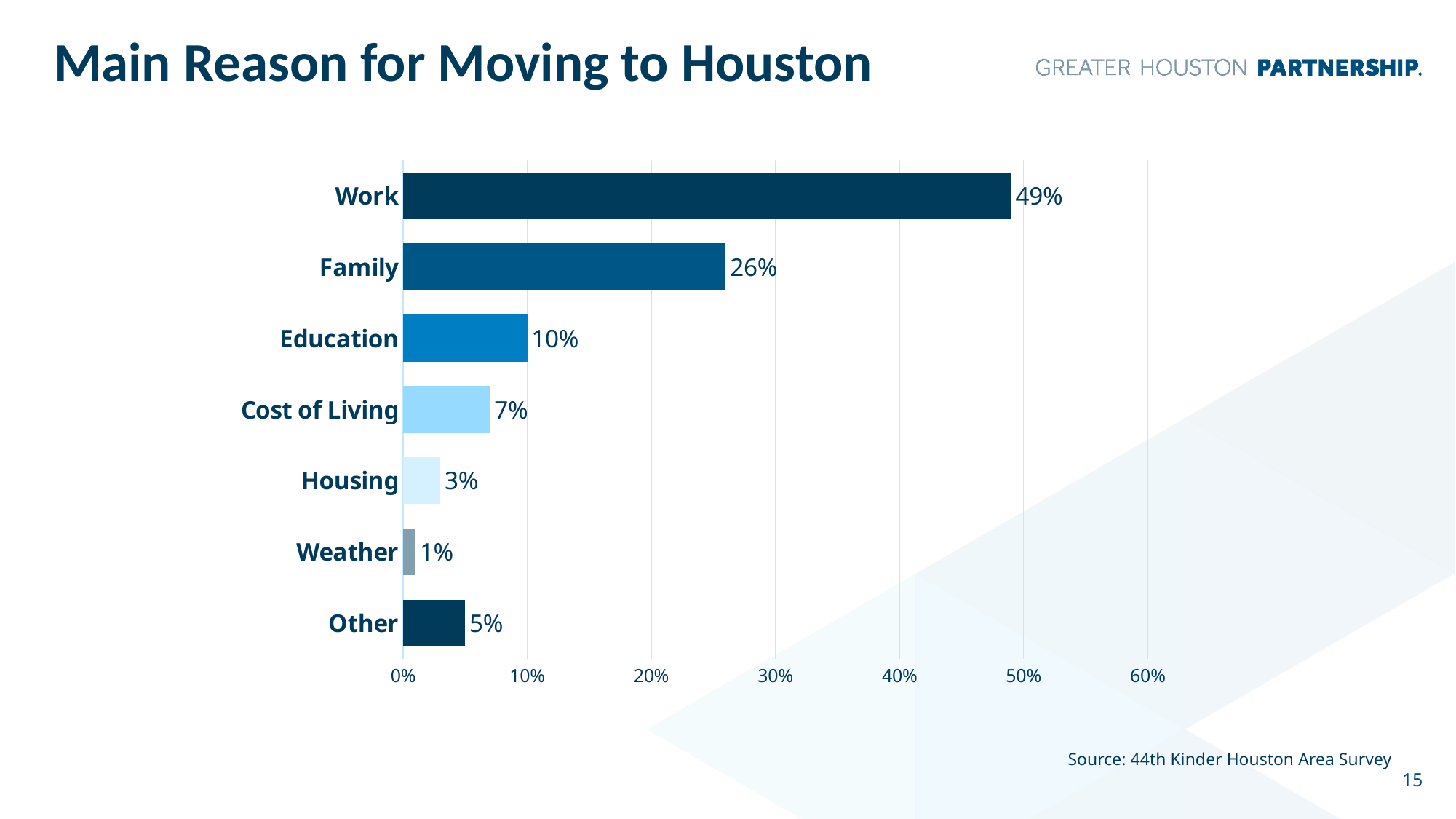
What is the title of the chart? Main Reason for Moving to Houston Is the value for Family greater or less than 30%? less How many reasons are listed on the chart? 7 Which reason has the highest percentage? Work What kind of chart is shown on the slide? Bar chart Which is larger, the value for Other or the value for Housing? Other What is the value shown for Family? 26% What percentage of respondents cited Work as their main reason for moving to Houston? 49% Which reason has the lowest percentage? Weather What is the difference in percentage points between Work and Family? 23 What percentage is shown for Cost of Living? 7% What is the difference in percentage points between Education and Housing? 7